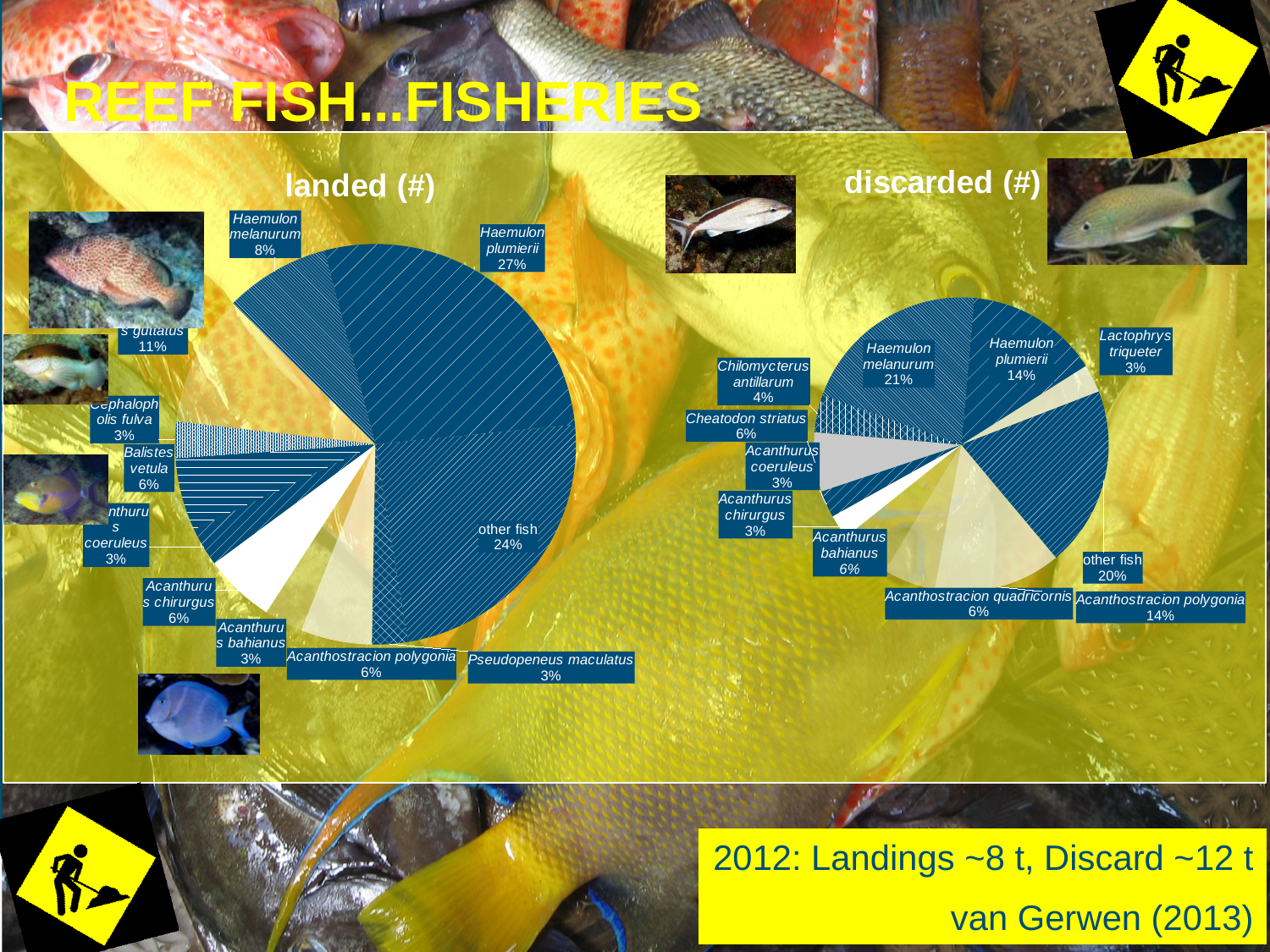
In the 'discarded (#)' chart, what is the difference between the shares of Haemulon melanurum and Haemulon plumierii? 7% How many slices does the 'discarded (#)' chart have? 11 In the 'discarded (#)' chart, what share is Haemulon melanurum? 21% Which is larger in the 'landed (#)' chart: Haemulon melanurum or Acanthurus chirurgus? Haemulon melanurum Which is larger in the 'discarded (#)' chart: Acanthurus bahianus or Acanthurus chirurgus? Acanthurus bahianus In the 'landed (#)' chart, what is the difference between the shares of Haemulon plumierii and other fish? 3% In the 'landed (#)' chart, what share is Haemulon plumierii? 27% In the 'landed (#)' chart, what share is Balistes vetula? 6% In the 'discarded (#)' chart, which category has the largest share? Haemulon melanurum In the 'discarded (#)' chart, what share is Acanthostracion polygonia? 14% In the 'landed (#)' chart, which named species has the largest share? Haemulon plumierii What type of chart is used for 'landed (#)' and 'discarded (#)'? Pie chart